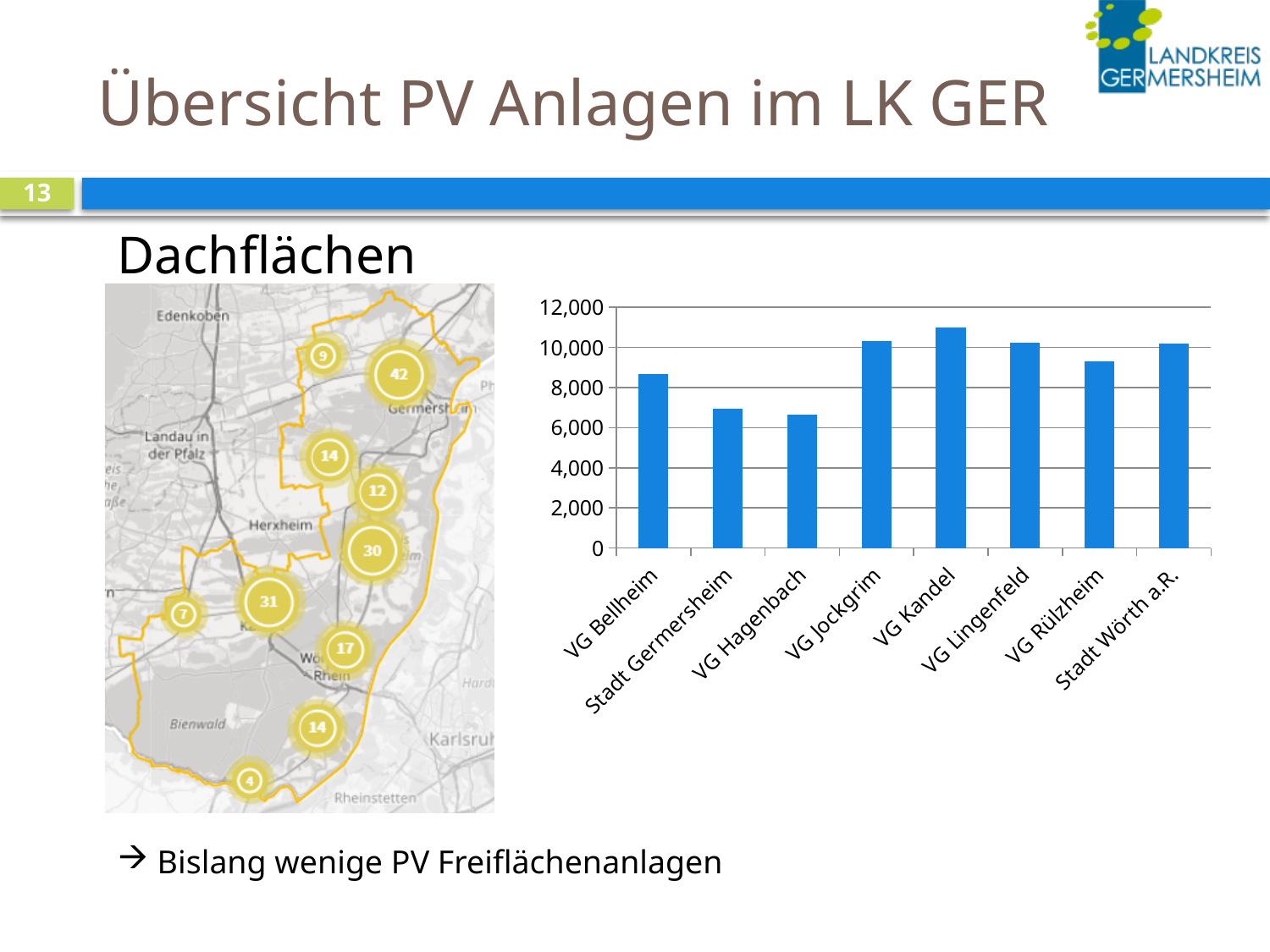
How many categories are shown on the x axis of the bar chart? 8 Is the value for VG Hagenbach greater or less than 6,000? greater Is the value for VG Kandel greater or less than 10,000? greater What colour are the bars in the chart? blue Which category has the highest bar in the chart? VG Kandel Which is larger, the value for VG Jockgrim or the value for Stadt Germersheim? VG Jockgrim What kind of chart is shown on the right side of the slide? bar chart Is the value for VG Bellheim greater or less than 8,000? greater Which is larger, the value for VG Kandel or the value for VG Bellheim? VG Kandel What is the highest value shown on the y axis of the bar chart? 12,000